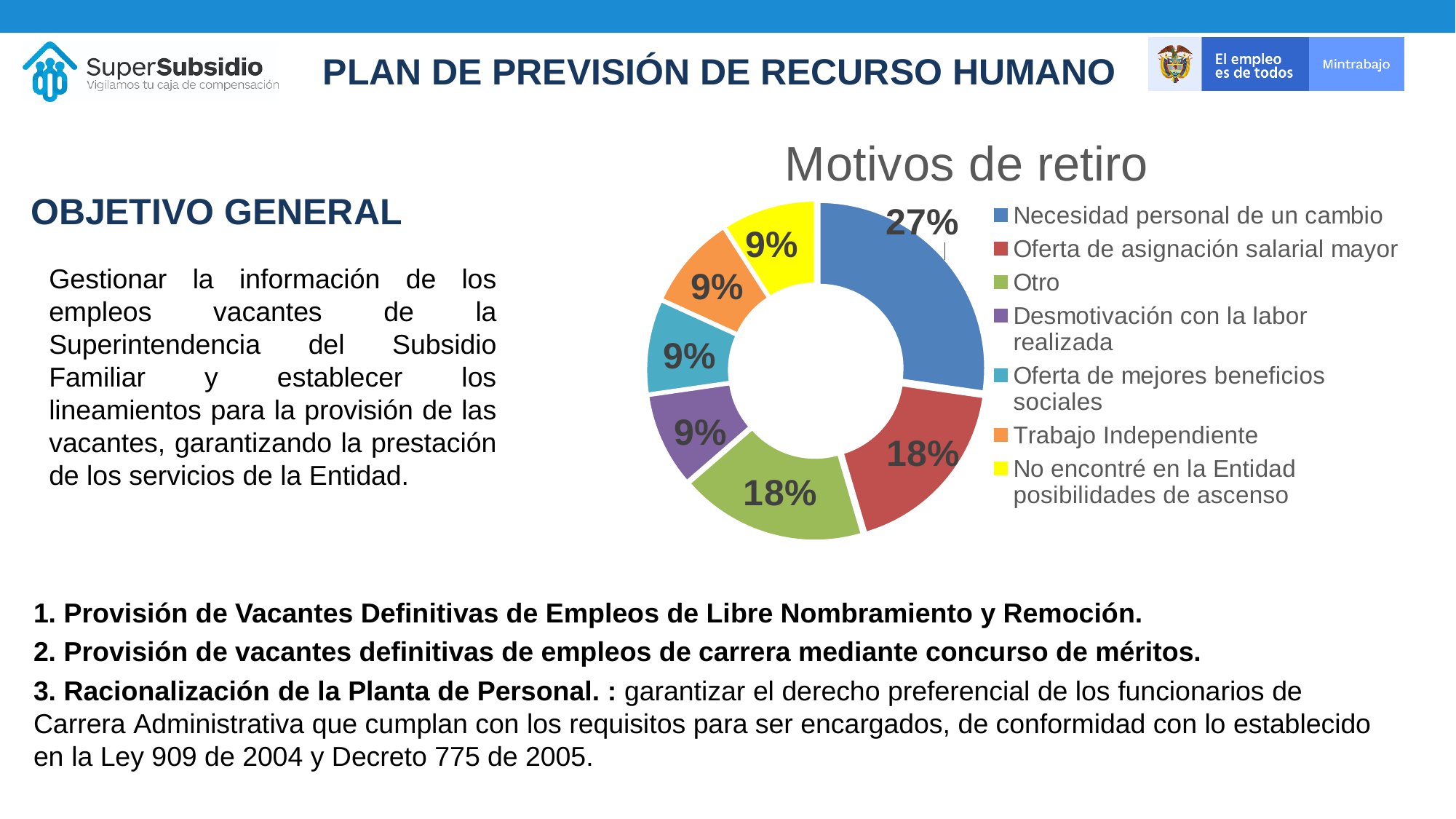
What is the value for "Trabajo Independiente"? 9% What is the value for "Otro"? 18% What kind of chart is shown on the slide? Doughnut chart Which category has the largest share of the pie? Necesidad personal de un cambio What is the value for "No encontré en la Entidad posibilidades de ascenso"? 9% What is the value for "Oferta de asignación salarial mayor"? 18% Which colour represents "Desmotivación con la labor realizada" in the chart? Purple What is the difference between the share for "Necesidad personal de un cambio" and the share for "Oferta de asignación salarial mayor"? 9% How many categories does the chart show? 7 Which is larger: "Necesidad personal de un cambio" or "Otro"? Necesidad personal de un cambio What share of the pie does "Necesidad personal de un cambio" represent? 27% What is the title of the chart? Motivos de retiro